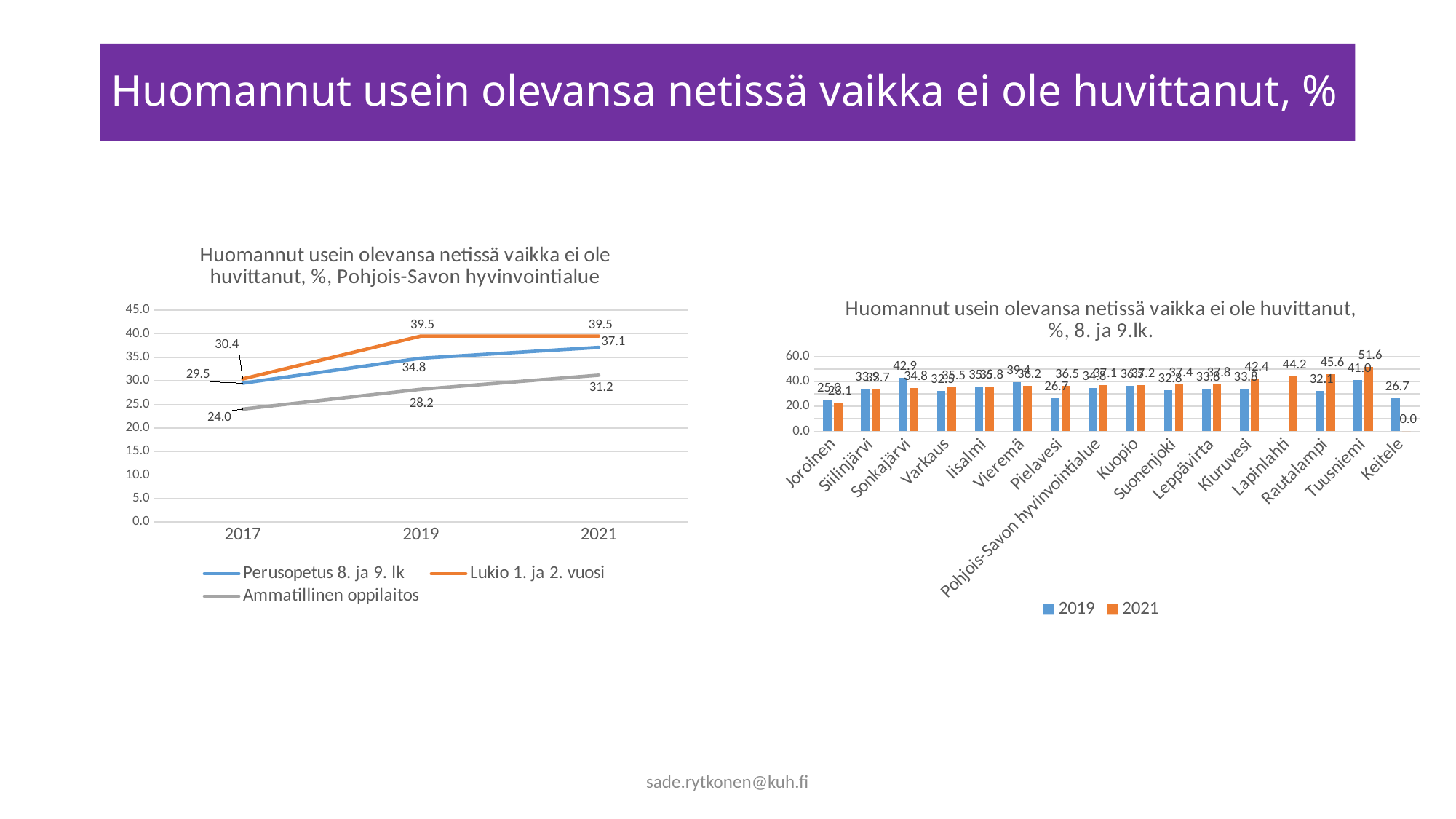
In the right bar chart (8. ja 9.lk.), which municipality has the highest 2021 value? Tuusniemi In the right bar chart (8. ja 9.lk.), which is larger for Kiuruvesi, the 2019 value or the 2021 value? 2021 In the left line chart (Pohjois-Savon hyvinvointialue), what is the difference between Lukio 1. ja 2. vuosi and Ammatillinen oppilaitos in 2021? 8.3 What kind of chart is the right-hand chart (8. ja 9.lk.)? bar chart In the left line chart (Pohjois-Savon hyvinvointialue), what is the value for Perusopetus 8. ja 9. lk in 2021? 37.1 In the right bar chart (8. ja 9.lk.), what is the 2021 value for Tuusniemi? 51.6 In the left line chart (Pohjois-Savon hyvinvointialue), how many series does the legend list? 3 In the left line chart (Pohjois-Savon hyvinvointialue), what is the value for Ammatillinen oppilaitos in 2017? 24.0 In the right bar chart (8. ja 9.lk.), what is the 2019 value for Sonkajärvi? 42.9 In the left line chart (Pohjois-Savon hyvinvointialue), what is the value for Lukio 1. ja 2. vuosi in 2019? 39.5 In the right bar chart (8. ja 9.lk.), how many categories are shown on the x axis? 16 In the left line chart (Pohjois-Savon hyvinvointialue), does the Perusopetus 8. ja 9. lk series rise or fall from 2017 to 2021? rise